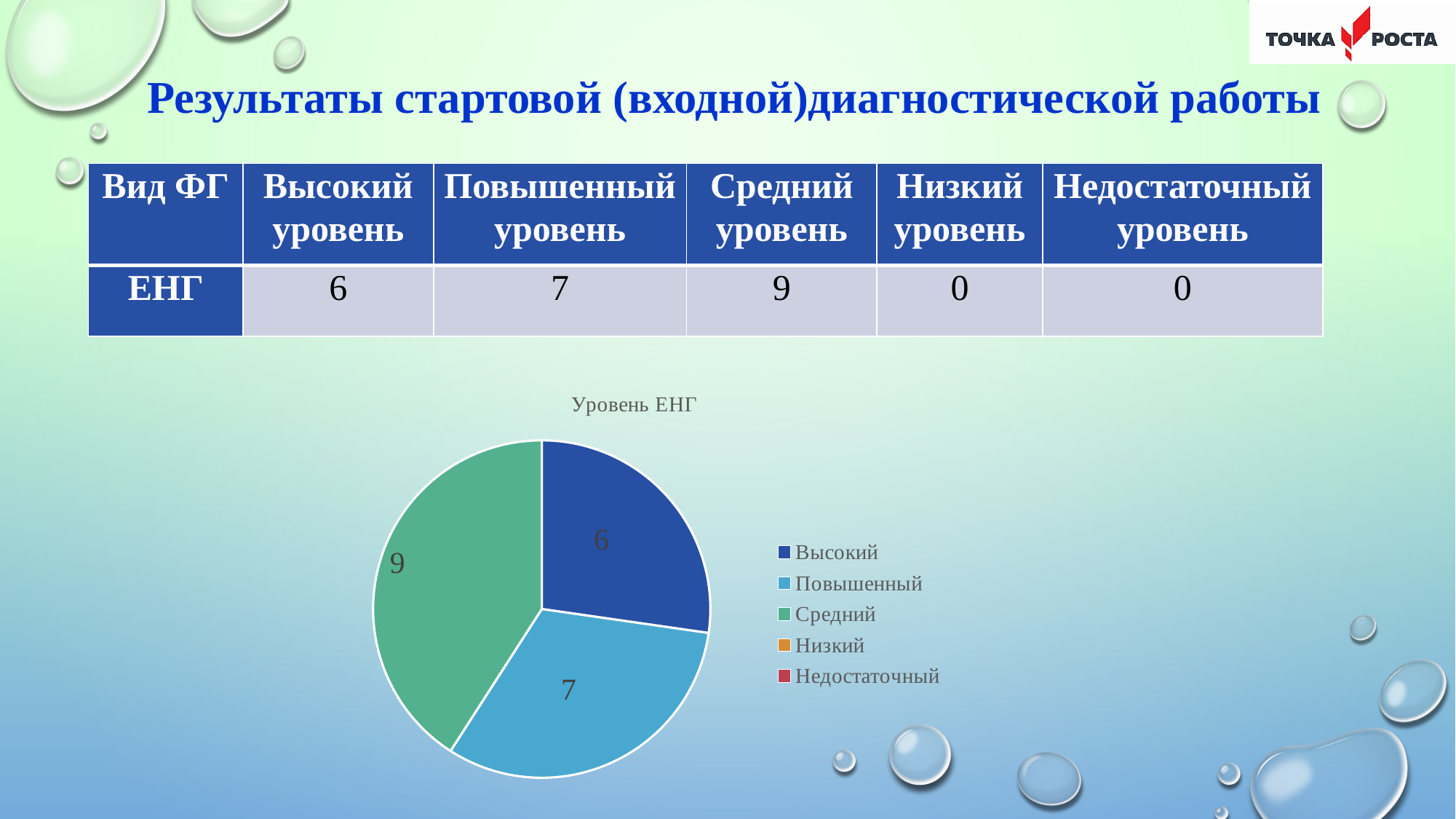
What colour is the Средний slice in the pie chart? Green How many entries does the legend of the pie chart list? 5 What value is shown for the Средний slice of the pie chart? 9 Which is larger in the pie chart, Повышенный or Высокий? Повышенный What is the total of the values labelled on the pie chart? 22 What type of chart is shown on the slide? Pie chart What value is shown for the Высокий slice of the pie chart? 6 What value is shown for the Повышенный slice of the pie chart? 7 Which category has the largest slice in the pie chart? Средний Which of the labelled slices in the pie chart is the smallest? Высокий What is the difference between the Средний and Высокий values in the pie chart? 3 What is the title of the chart? Уровень ЕНГ